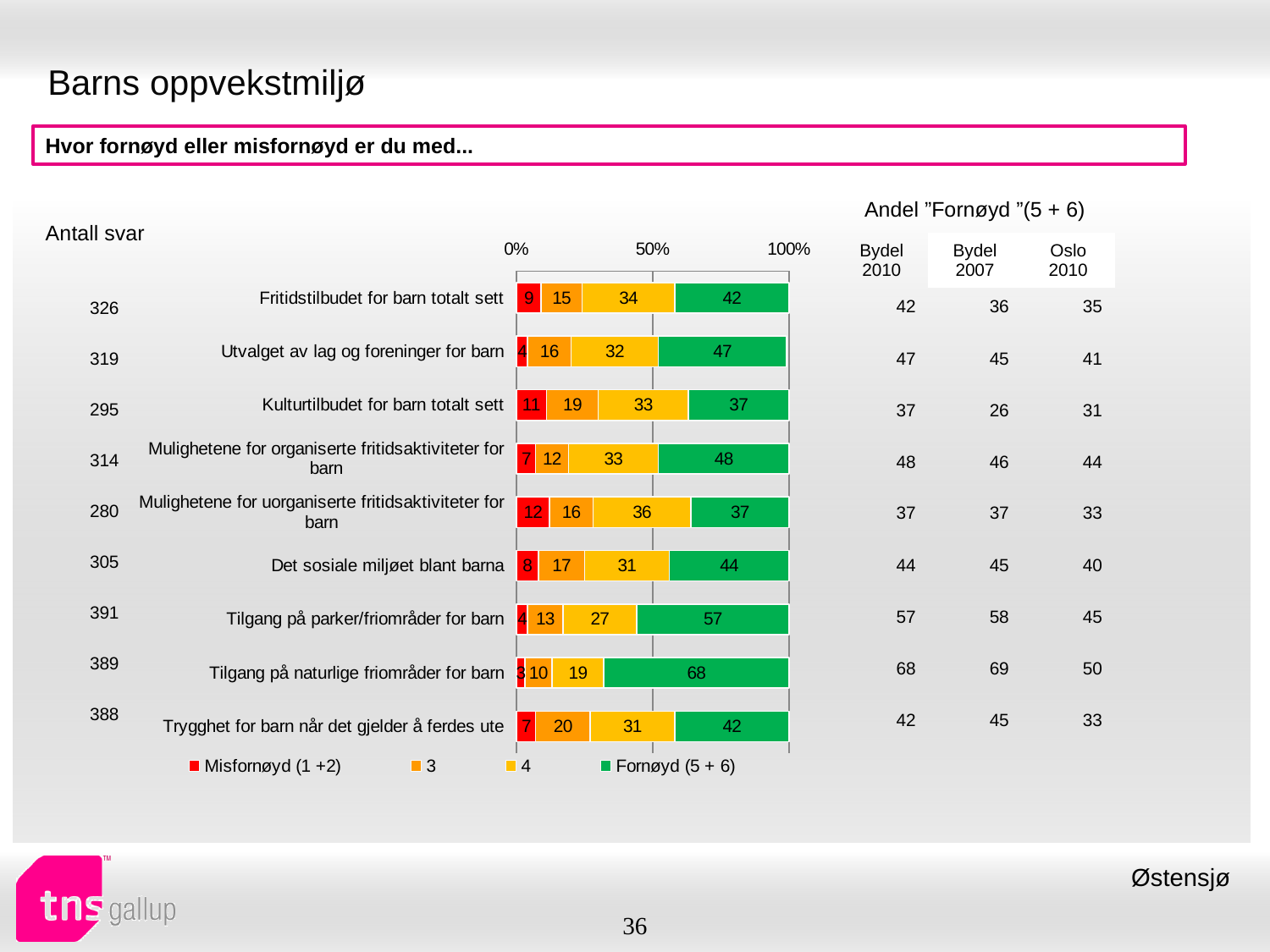
Which category has the lowest 'Misfornøyd (1 +2)' value? Tilgang på naturlige friområder for barn What kind of chart is shown on the slide? stacked bar chart What is the 'Fornøyd (5 + 6)' value for 'Tilgang på naturlige friområder for barn'? 68 What is the total of the stacked bar for 'Trygghet for barn når det gjelder å ferdes ute'? 100 How many series does the chart legend list? 4 What is the value of series '4' for 'Mulighetene for uorganiserte fritidsaktiviteter for barn'? 36 What is the label of the first (red) series in the legend? Misfornøyd (1 +2) Which has a larger 'Fornøyd (5 + 6)' value: 'Utvalget av lag og foreninger for barn' or 'Fritidstilbudet for barn totalt sett'? Utvalget av lag og foreninger for barn What is the 'Misfornøyd (1 +2)' value for 'Kulturtilbudet for barn totalt sett'? 11 How many categories (questions) are plotted in the bar chart? 9 Which category has the highest 'Fornøyd (5 + 6)' value? Tilgang på naturlige friområder for barn What is the difference between the 'Fornøyd (5 + 6)' values for 'Tilgang på parker/friområder for barn' and 'Det sosiale miljøet blant barna'? 13